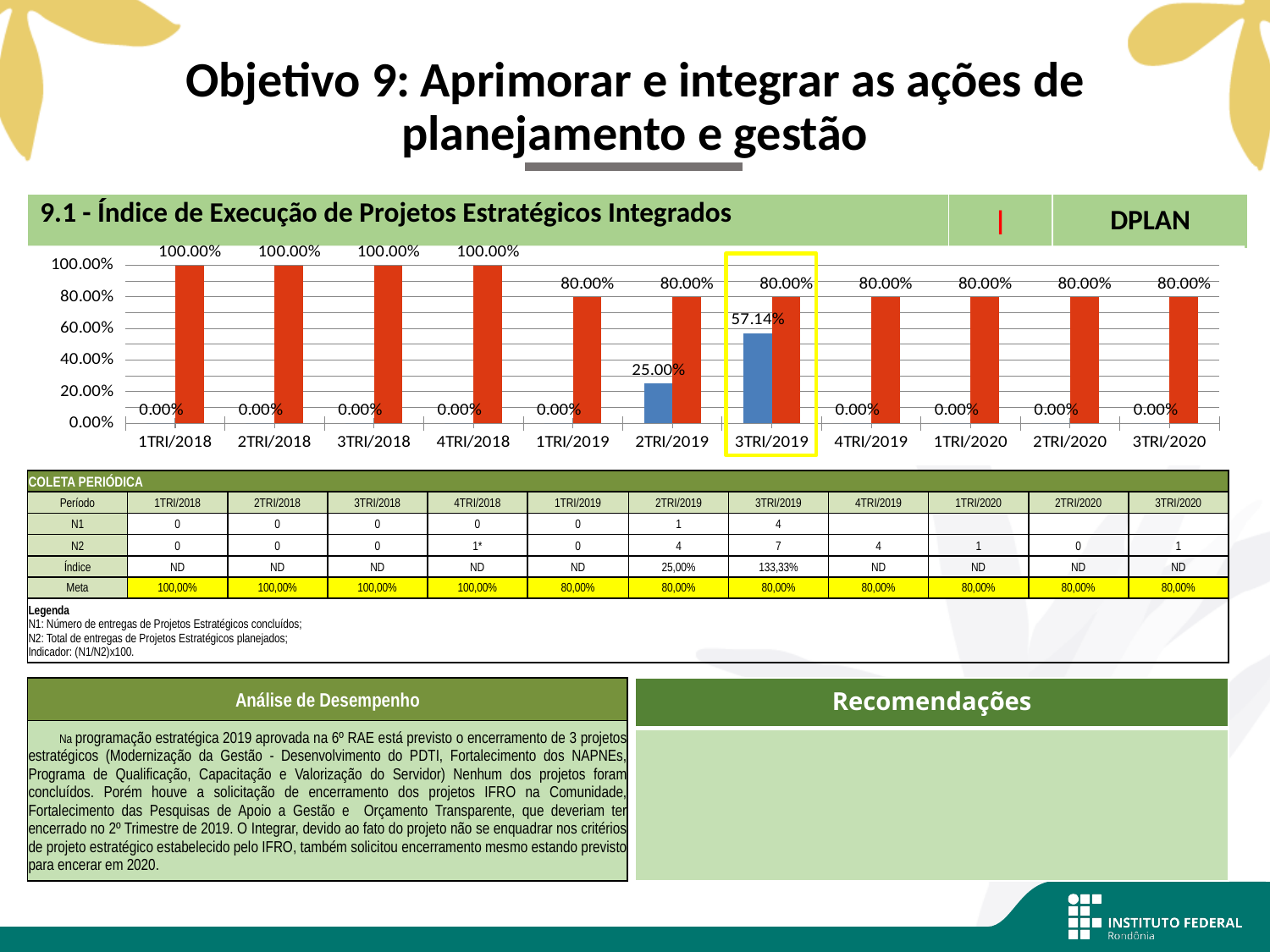
How many periods (categories) are shown on the x axis of the chart? 11 What is the value of the blue bar for 3TRI/2019? 57.14% What is the value of the red bar for 3TRI/2020? 80.00% What is the value of the red bar for 1TRI/2018? 100.00% Which period has the highest blue bar? 3TRI/2019 What type of chart is shown on the slide? bar chart What is the difference between the red bar for 4TRI/2018 and the red bar for 1TRI/2019? 20.00% Which period on the x axis is highlighted with a yellow box? 3TRI/2019 Do the red bars rise or fall from 4TRI/2018 to 1TRI/2019? fall What is the difference between the red bar and the blue bar for 3TRI/2019? 22.86% Which is larger for 2TRI/2019, the blue bar or the red bar? the red bar What is the value of the blue bar for 2TRI/2019? 25.00%